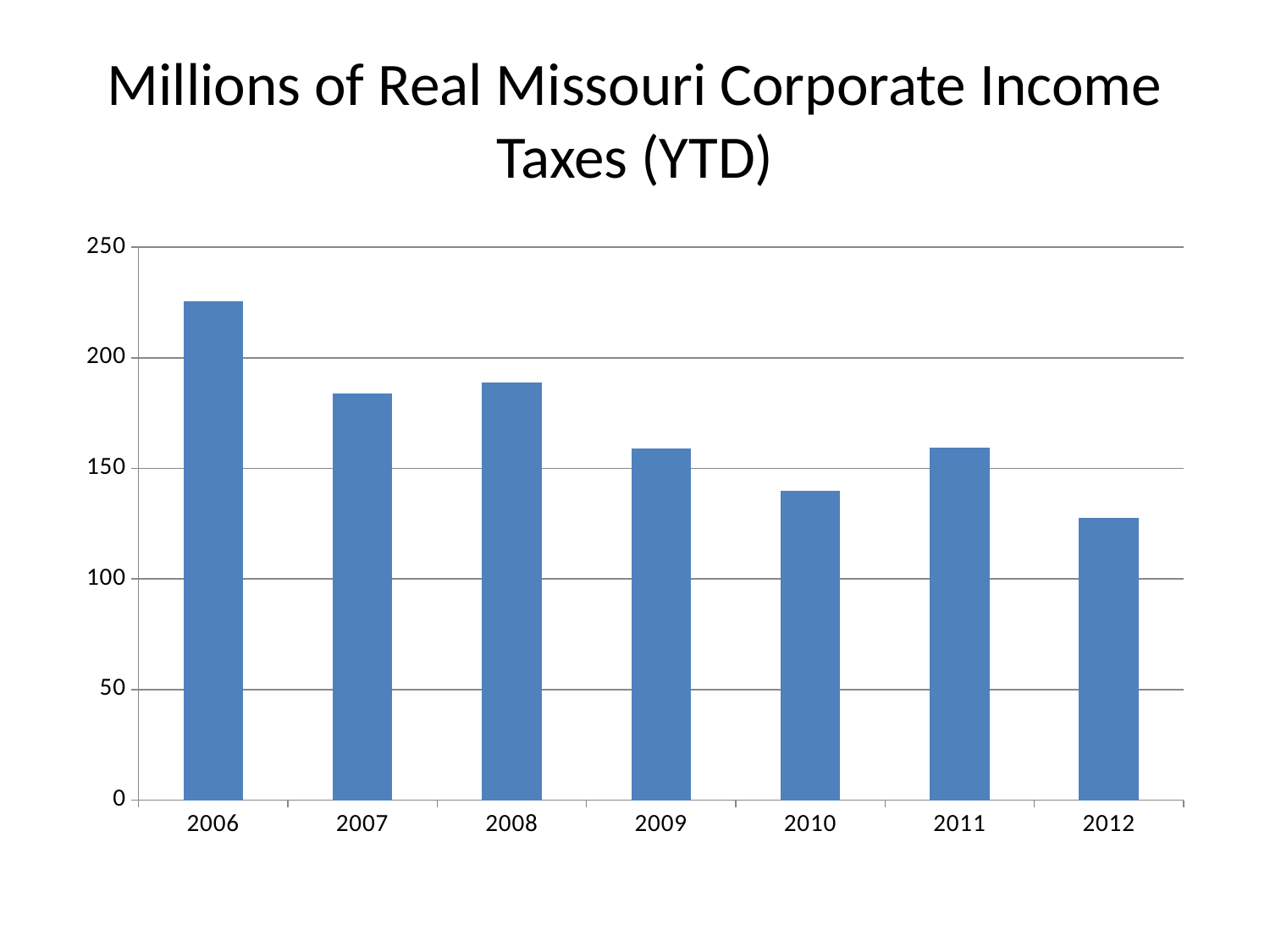
Which year has the lowest value in the chart? 2012 What kind of chart is shown on the slide? bar chart Is the value for 2010 greater or less than 150? less How many years are shown on the x axis of the chart? 7 Is the value for 2007 greater or less than 200? less Which is larger, the value for 2006 or the value for 2007? 2006 Which is larger, the value for 2010 or the value for 2012? 2010 Is the value for 2012 greater or less than 150? less What is the title of the chart? Millions of Real Missouri Corporate Income Taxes (YTD) Which year has the highest value in the chart? 2006